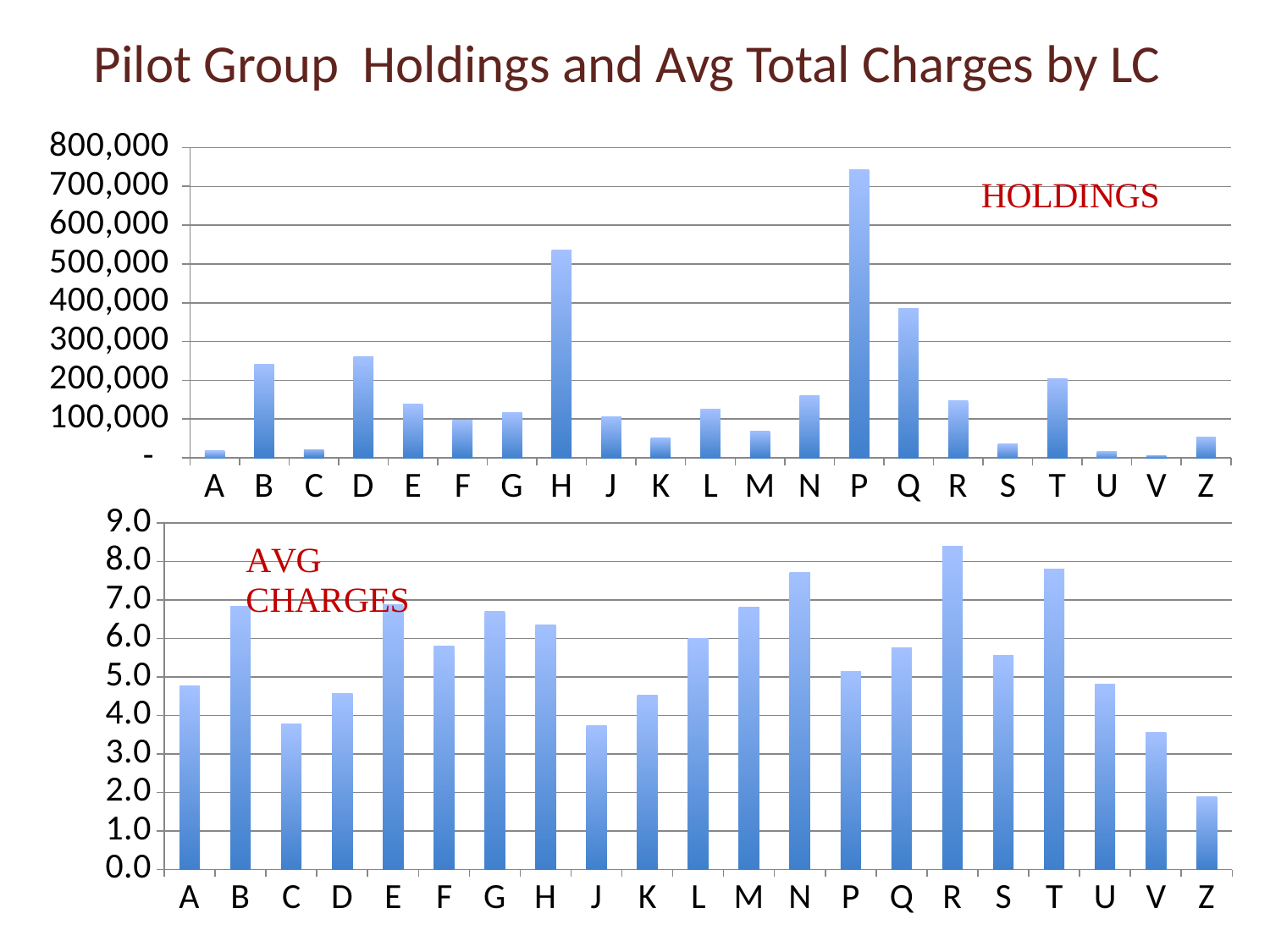
What kind of chart is the HOLDINGS chart at the top of the slide? bar chart In the AVG CHARGES chart, is the value for N greater or less than 7.0? greater In the HOLDINGS chart, is the value for H greater or less than 500,000? greater In the HOLDINGS chart, which category has the highest value? P In the AVG CHARGES chart at the bottom, which category has the lowest value? Z In the AVG CHARGES chart at the bottom, which category has the highest value? R In the HOLDINGS chart, which is larger, the value for H or the value for Q? H How many categories are shown on the x axis of the HOLDINGS chart? 21 In the HOLDINGS chart, which category has the lowest value? V In the AVG CHARGES chart, which is larger, the value for A or the value for B? B In the AVG CHARGES chart, is the value for C greater or less than 4.0? less